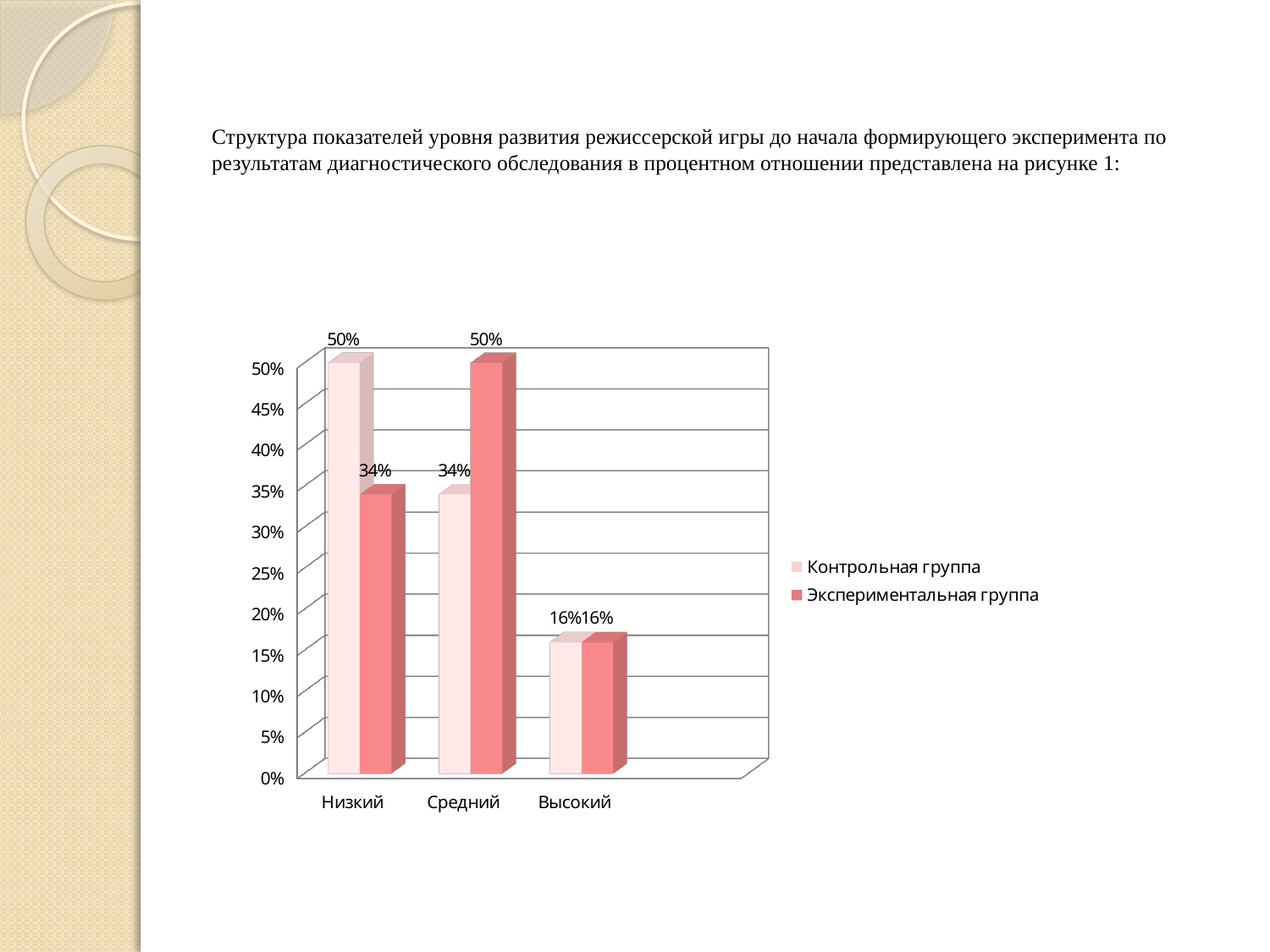
What is the value for Экспериментальная группа at the Низкий level? 34% Which level has the lowest value for Контрольная группа? Высокий What is the value for Контрольная группа at the Высокий level? 16% What is the value for Контрольная группа at the Низкий level? 50% Which level has the highest value for Экспериментальная группа? Средний Which group has the larger value at the Средний level? Экспериментальная группа Which series is shown in the darker red colour? Экспериментальная группа How many series does the legend list? 2 What is the value for Экспериментальная группа at the Средний level? 50% What is the difference between Контрольная группа and Экспериментальная группа at the Низкий level? 16% How many levels are shown on the x axis? 3 What kind of chart is shown on the slide? Bar chart